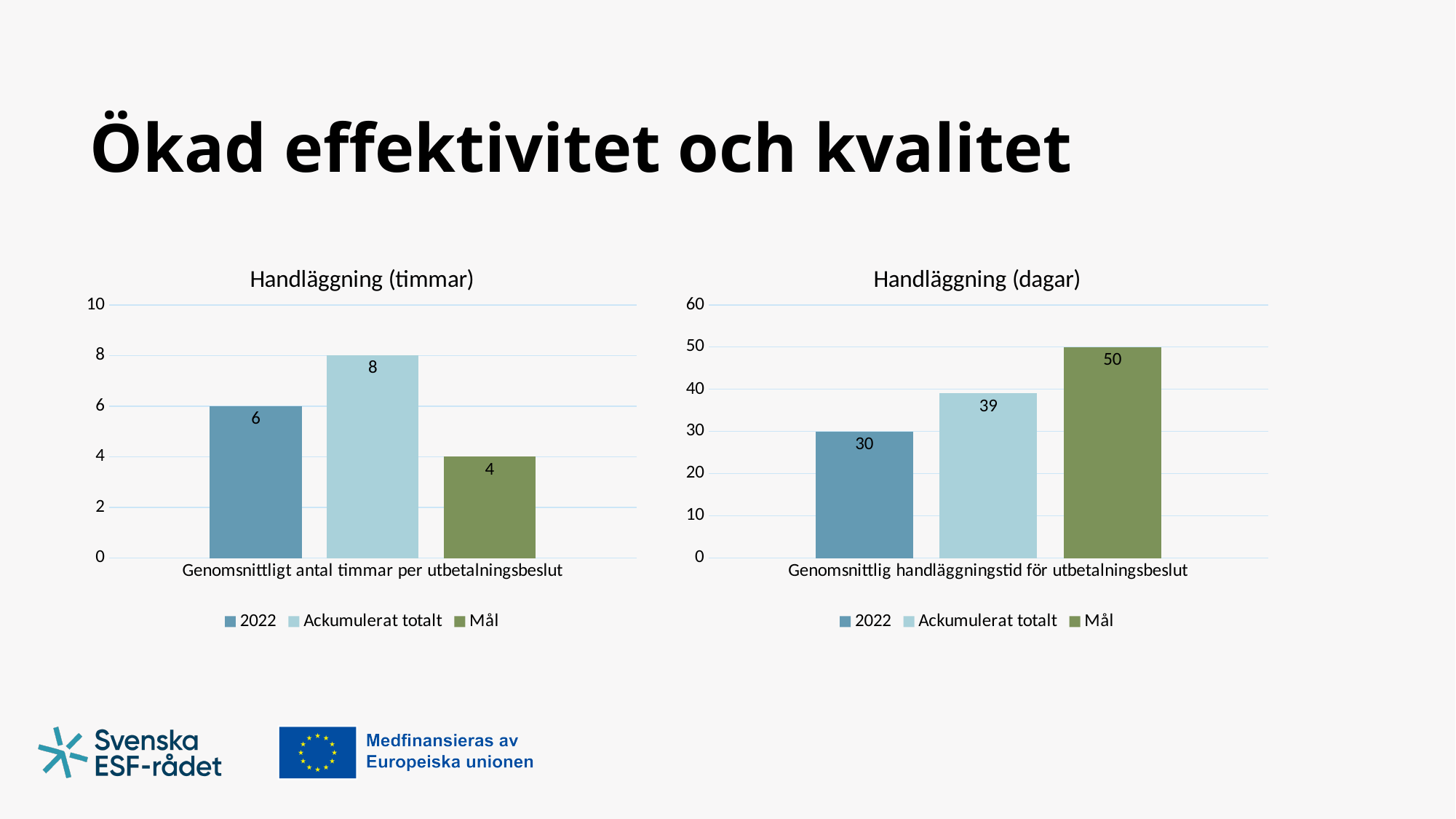
In the 'Handläggning (timmar)' chart, what is the difference between Ackumulerat totalt and 2022? 2 In the 'Handläggning (dagar)' chart, what is the value for Ackumulerat totalt? 39 In the 'Handläggning (timmar)' chart, what is the value for 2022? 6 In the 'Handläggning (dagar)' chart, which series has the highest value? Mål In the 'Handläggning (dagar)' chart, which is larger, the value for 2022 or the value for Ackumulerat totalt? Ackumulerat totalt In the 'Handläggning (timmar)' chart, which series has the lowest value? Mål In the 'Handläggning (dagar)' chart, what is the difference between the Mål value and the 2022 value? 20 In the 'Handläggning (timmar)' chart, what is the value for Ackumulerat totalt? 8 In the 'Handläggning (dagar)' chart, what is the value for 2022? 30 What kind of chart is the 'Handläggning (timmar)' chart? Bar chart In the 'Handläggning (timmar)' chart, what is the value for Mål? 4 How many series does the legend of the 'Handläggning (dagar)' chart list? 3